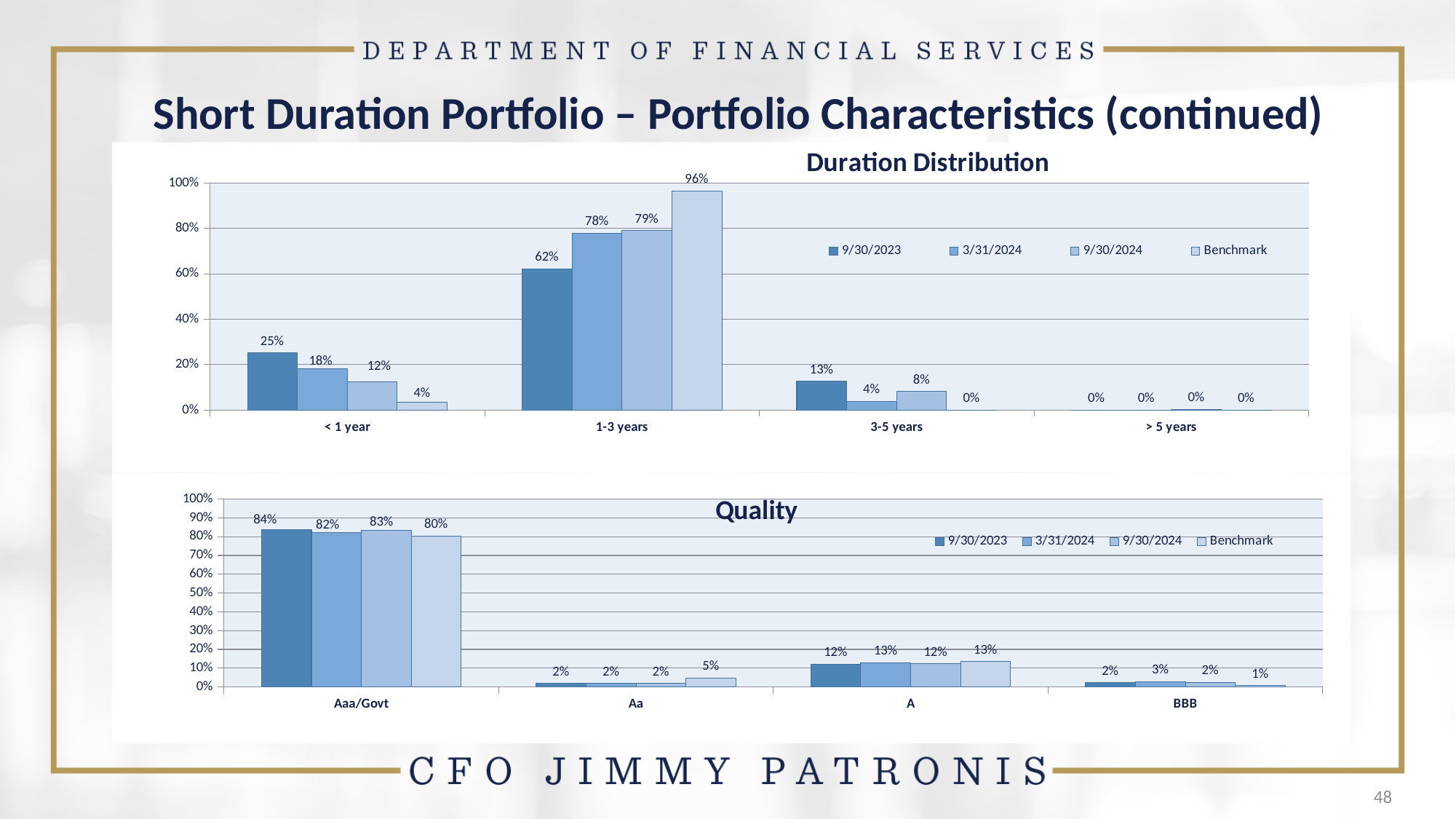
In the Duration Distribution chart, what is the 9/30/2023 value for < 1 year? 25% In the Duration Distribution chart, what is the difference between the 3/31/2024 and 9/30/2023 values for 1-3 years? 16% In the Duration Distribution chart, which duration bucket has the highest 9/30/2024 value? 1-3 years In the Duration Distribution chart, how many duration categories are shown on the x axis? 4 In the Quality chart, what is the 9/30/2024 value for Aaa/Govt? 83% In the Quality chart, which rating category has the lowest Benchmark value? BBB In the Quality chart, what is the Benchmark value for Aa? 5% In the Duration Distribution chart, how many series does the legend list? 4 In the Duration Distribution chart, what is the Benchmark value for 1-3 years? 96% What kind of chart is the Quality chart? bar chart In the Quality chart, what is the difference between the 9/30/2023 and Benchmark values for Aaa/Govt? 4% In the Quality chart, is the 9/30/2023 value for A larger or smaller than the 9/30/2023 value for BBB? larger